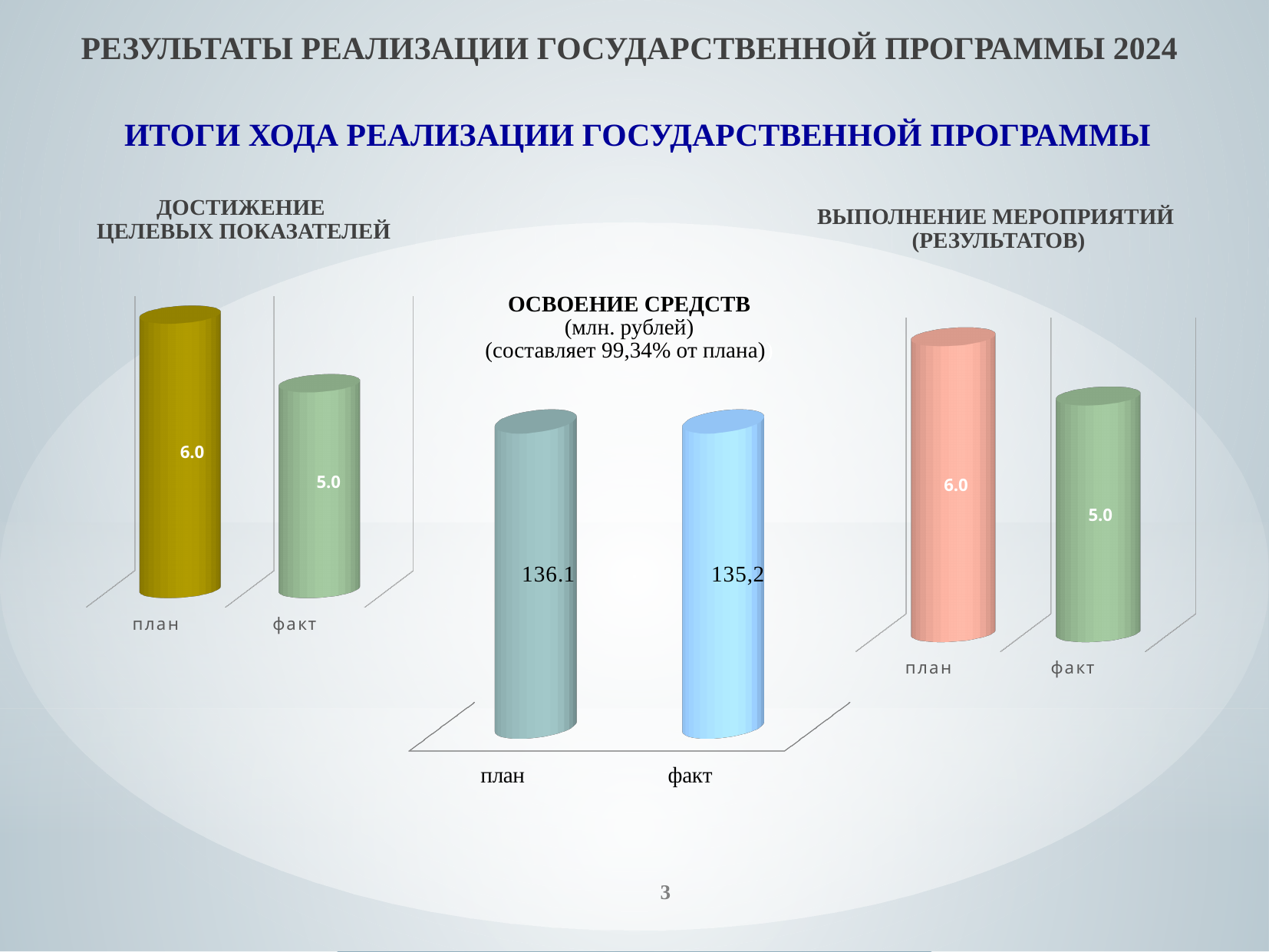
In the chart titled ВЫПОЛНЕНИЕ МЕРОПРИЯТИЙ (РЕЗУЛЬТАТОВ), what is the value for факт? 5.0 In the chart titled ДОСТИЖЕНИЕ ЦЕЛЕВЫХ ПОКАЗАТЕЛЕЙ, what is the difference between план and факт? 1.0 According to the subtitle of the chart titled ОСВОЕНИЕ СРЕДСТВ, what percentage of the plan does the actual value represent? 99,34% In the chart titled ОСВОЕНИЕ СРЕДСТВ, what is the value for план? 136.1 How many categories does the chart titled ОСВОЕНИЕ СРЕДСТВ show? 2 In the chart titled ОСВОЕНИЕ СРЕДСТВ, which is larger, план or факт? план In the chart titled ДОСТИЖЕНИЕ ЦЕЛЕВЫХ ПОКАЗАТЕЛЕЙ, what is the value for факт? 5.0 In the chart titled ДОСТИЖЕНИЕ ЦЕЛЕВЫХ ПОКАЗАТЕЛЕЙ, what is the value for план? 6.0 In the chart titled ОСВОЕНИЕ СРЕДСТВ, what is the value for факт? 135,2 In the chart titled ВЫПОЛНЕНИЕ МЕРОПРИЯТИЙ (РЕЗУЛЬТАТОВ), which category has the highest value? план What kind of chart is the chart titled ВЫПОЛНЕНИЕ МЕРОПРИЯТИЙ (РЕЗУЛЬТАТОВ)? bar chart In the chart titled ДОСТИЖЕНИЕ ЦЕЛЕВЫХ ПОКАЗАТЕЛЕЙ, which category has the lowest value? факт